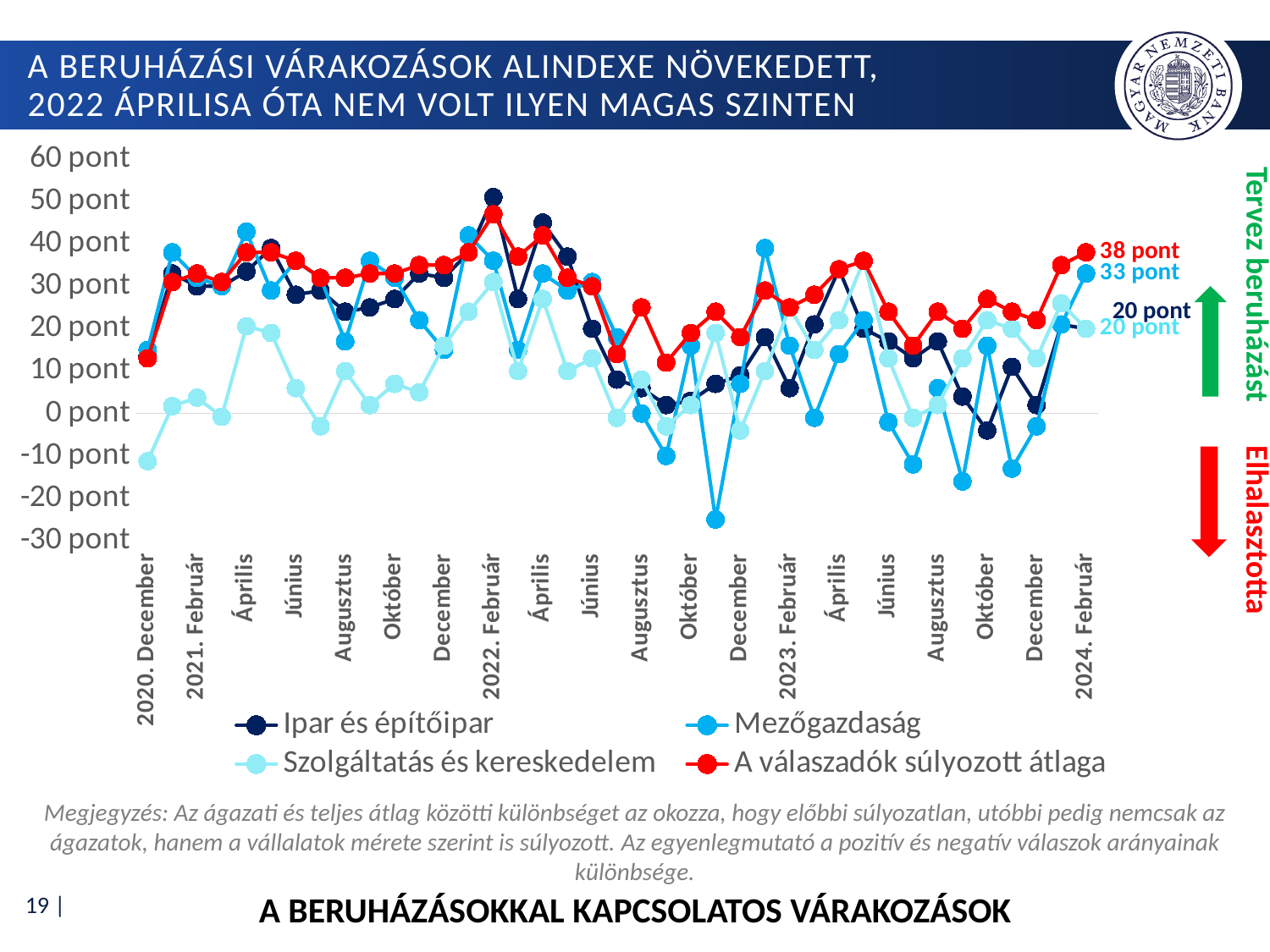
Which series has the highest value in 2024. Február? A válaszadók súlyozott átlaga Is the value for Ipar és építőipar in 2022. Február greater or less than 40 pont? greater In 2024. Február, which is larger: Mezőgazdaság or Ipar és építőipar? Mezőgazdaság What is the value of Ipar és építőipar in 2024. Február? 20 pont What is the value of Mezőgazdaság in 2024. Február? 33 pont What is the difference between A válaszadók súlyozott átlaga and Mezőgazdaság in 2024. Február? 5 pont Is the value for Szolgáltatás és kereskedelem in 2020. December greater or less than 0 pont? less What kind of chart is shown on the slide? Line chart How many series does the legend list? 4 What is the value of Szolgáltatás és kereskedelem in 2024. Február? 20 pont What is the value of A válaszadók súlyozott átlaga in 2024. Február? 38 pont What is the difference between A válaszadók súlyozott átlaga and Ipar és építőipar in 2024. Február? 18 pont